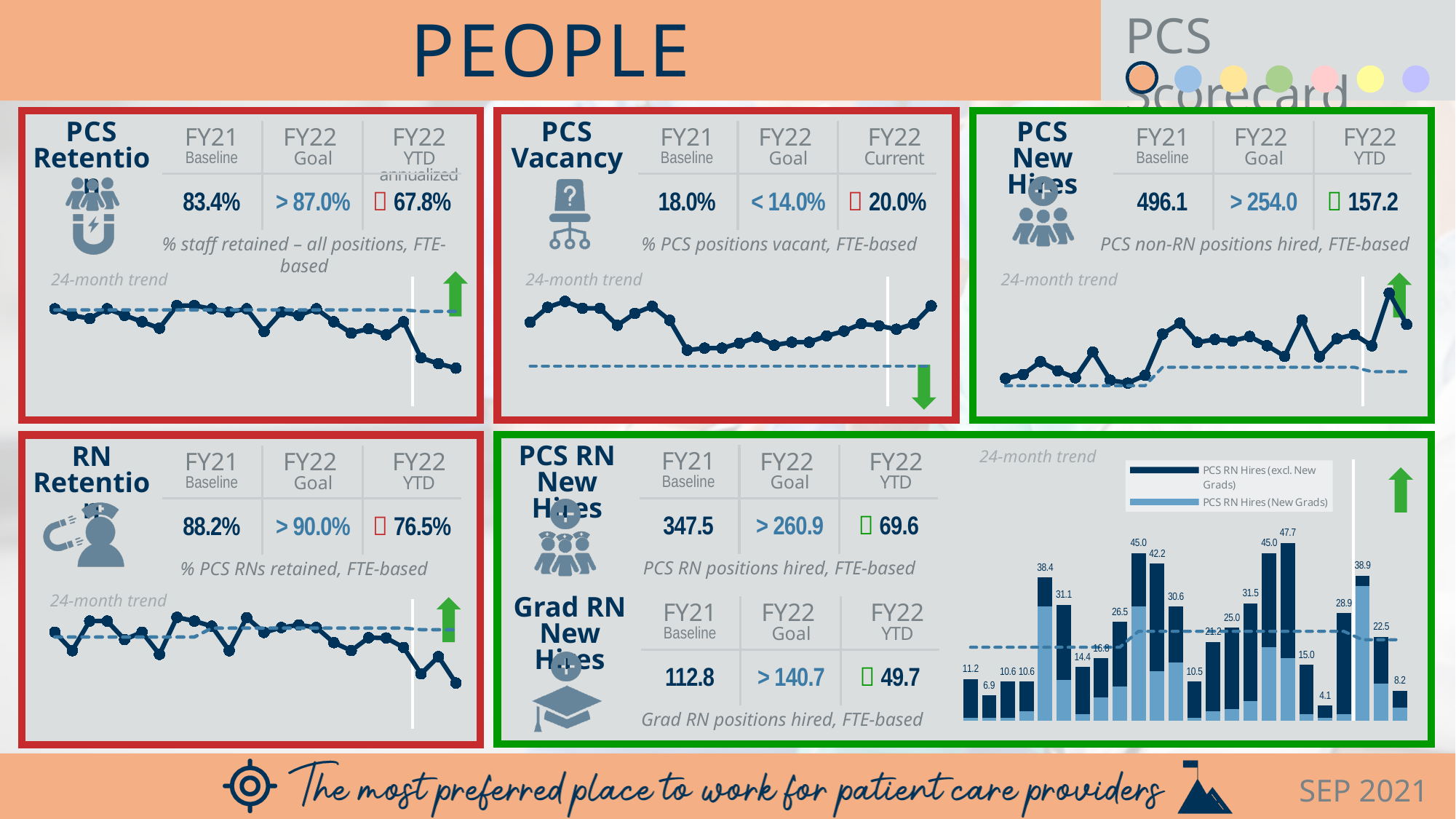
In the PCS RN New Hires bar chart, what total is labeled on the first (leftmost) bar? 11.2 How many bars are plotted in the PCS RN New Hires 24-month trend bar chart? 24 What is the highest total labeled on a bar in the PCS RN New Hires bar chart? 47.7 In the PCS RN New Hires bar chart, which is larger: the first bar (11.2) or the second bar (6.9)? the first bar (11.2) In the PCS New Hires panel's 24-month trend line chart, do the values generally rise or fall from left to right? rise What is the lowest total labeled on a bar in the PCS RN New Hires bar chart? 4.1 How many series does the legend of the PCS RN New Hires bar chart list? 2 What kind of chart is the 24-month trend chart in the PCS Retention panel? line chart In the PCS RN New Hires bar chart, what is the difference between the highest labeled bar total (47.7) and the lowest (4.1)? 43.6 What are the two series named in the legend of the PCS RN New Hires bar chart? PCS RN Hires (excl. New Grads) and PCS RN Hires (New Grads) What kind of chart is the 24-month trend chart in the PCS RN New Hires panel? bar chart In the PCS RN New Hires bar chart, what total is labeled on the last (rightmost) bar? 8.2